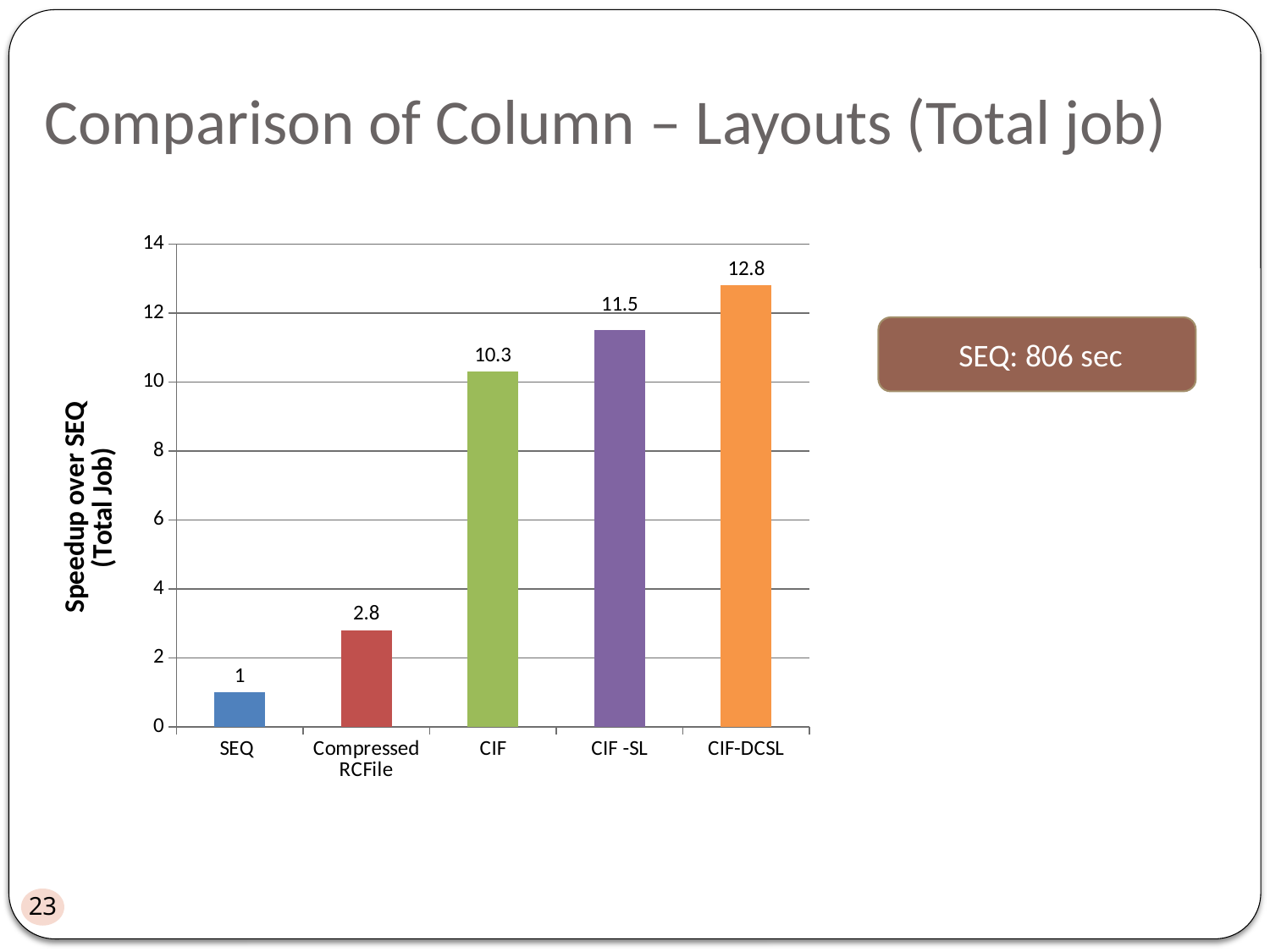
Which layout has the highest speedup over SEQ? CIF-DCSL What kind of chart is shown on the slide? bar chart Is the speedup for CIF -SL greater or less than 12? less What is the speedup over SEQ for CIF? 10.3 Which has a larger speedup over SEQ, CIF -SL or CIF? CIF -SL What is the difference in speedup between CIF and Compressed RCFile? 7.5 Which layout has the lowest speedup over SEQ? SEQ What is the speedup over SEQ for CIF-DCSL? 12.8 What is the difference in speedup between CIF-DCSL and CIF -SL? 1.3 How many layouts are shown on the x axis? 5 Do the speedup values rise or fall from left to right along the x axis? rise What is the speedup over SEQ for Compressed RCFile? 2.8